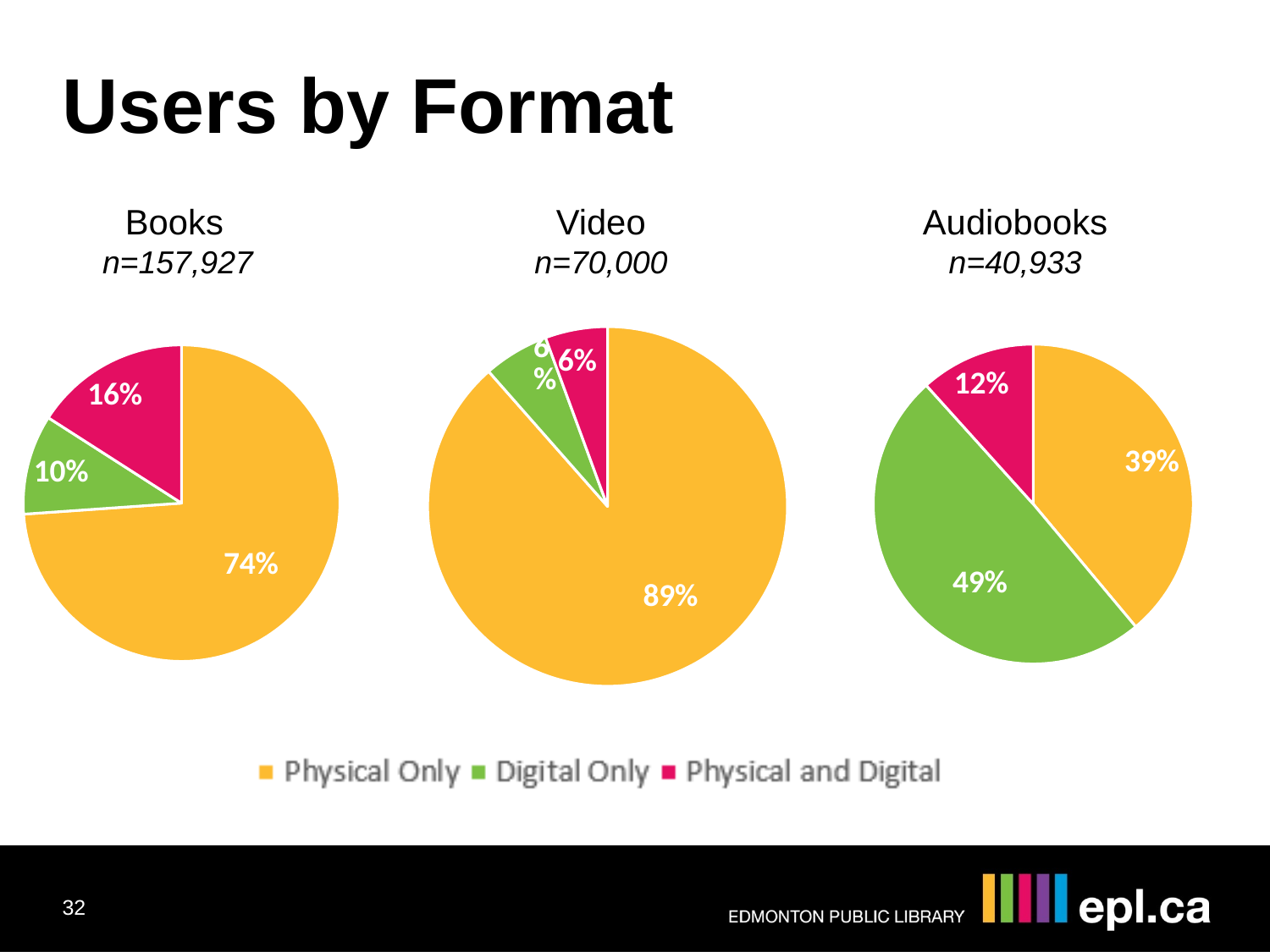
What type of chart is used for the Video chart? Pie chart In the Audiobooks pie chart, which category has the largest share? Digital Only In the Audiobooks pie chart, which is larger: Physical Only or Digital Only? Digital Only In the Audiobooks pie chart, what share of users is Physical and Digital? 12% In the Books pie chart, what share of users is Physical Only? 74% In the Books pie chart, what share of users is Digital Only? 10% In the Audiobooks pie chart, what is the difference between the Digital Only share and the Physical Only share? 10% In the Books pie chart, which category has the smallest share? Digital Only How many categories does the legend list for the pie charts? 3